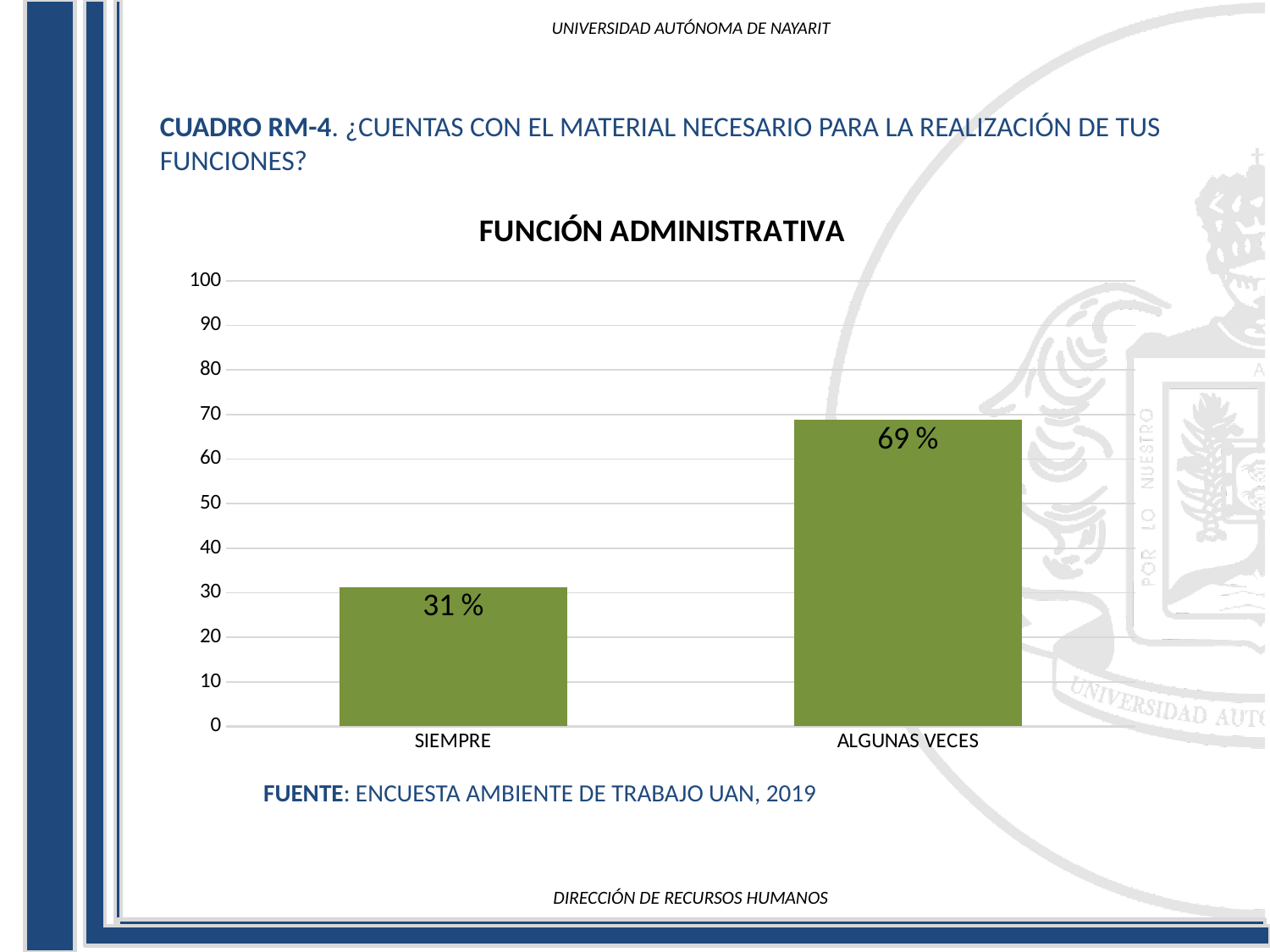
What is the highest value shown on the y axis? 100 Which category has the lowest value? SIEMPRE What is the value for SIEMPRE? 31 % What kind of chart is shown on the slide? bar chart What is the difference between the values for ALGUNAS VECES and SIEMPRE? 38 % Which is larger, the value for SIEMPRE or the value for ALGUNAS VECES? ALGUNAS VECES How many categories are shown on the x axis? 2 What is the title of the chart? FUNCIÓN ADMINISTRATIVA Is the value for SIEMPRE greater or less than 40? less What is the value for ALGUNAS VECES? 69 % Is the value for ALGUNAS VECES greater or less than 60? greater Which category has the highest value? ALGUNAS VECES